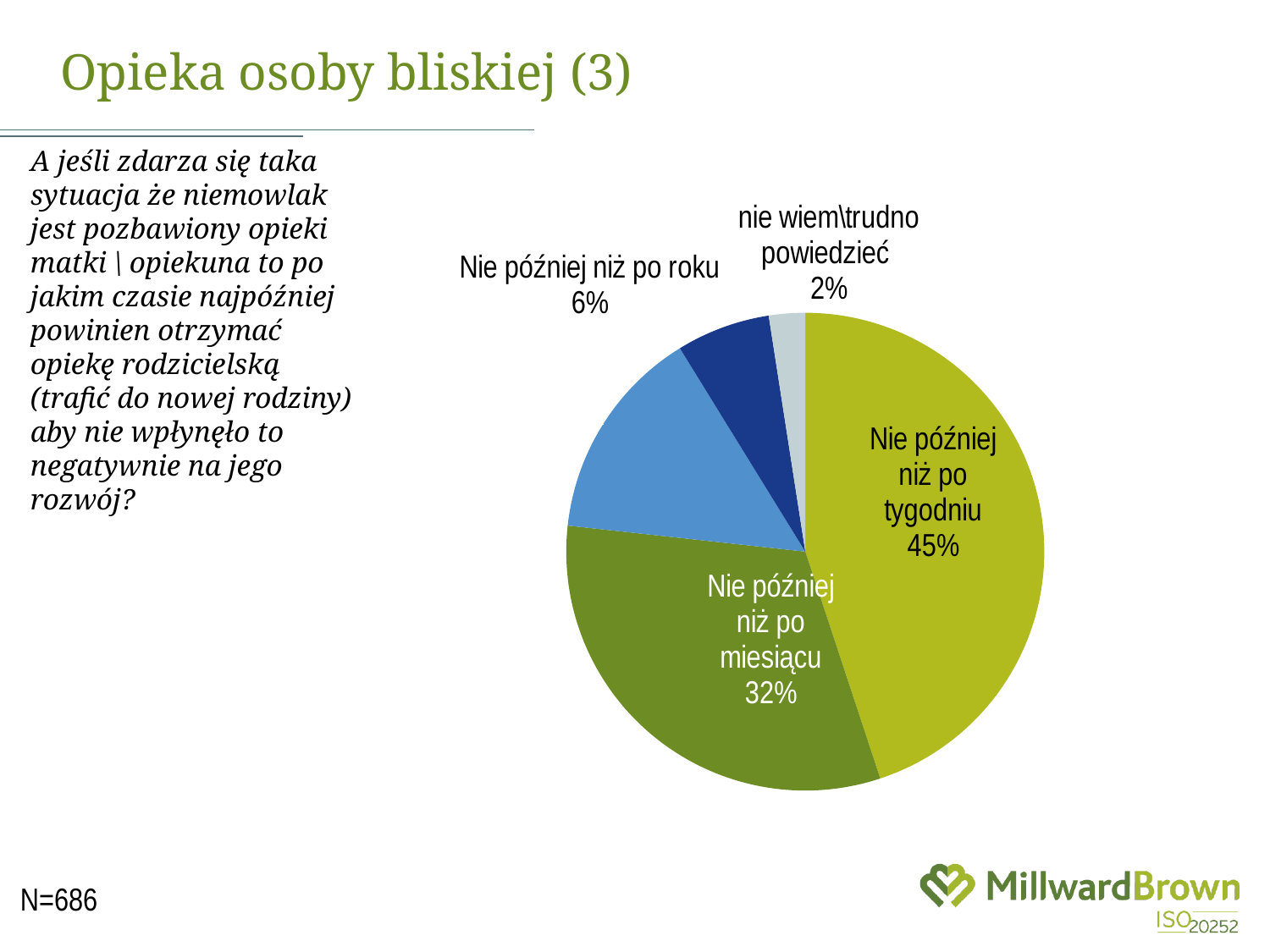
What colour is the slice for "Nie później niż po tygodniu"? Yellow-green What type of chart is shown on the slide? Pie chart What is the sample size (N) shown on the slide? N=686 Which answer has the largest share of the pie? Nie później niż po tygodniu What is the difference in percentage points between "Nie później niż po tygodniu" and "Nie później niż po miesiącu"? 13 How many slices does the pie chart have? 5 What percentage of respondents answered "Nie później niż po miesiącu"? 32% Which is larger: the share for "Nie później niż po roku" or for "nie wiem\trudno powiedzieć"? Nie później niż po roku What percentage of respondents answered "Nie później niż po tygodniu"? 45% Which labelled answer has the smallest share of the pie? nie wiem\trudno powiedzieć What percentage of respondents answered "nie wiem\trudno powiedzieć"? 2% What percentage of respondents answered "Nie później niż po roku"? 6%